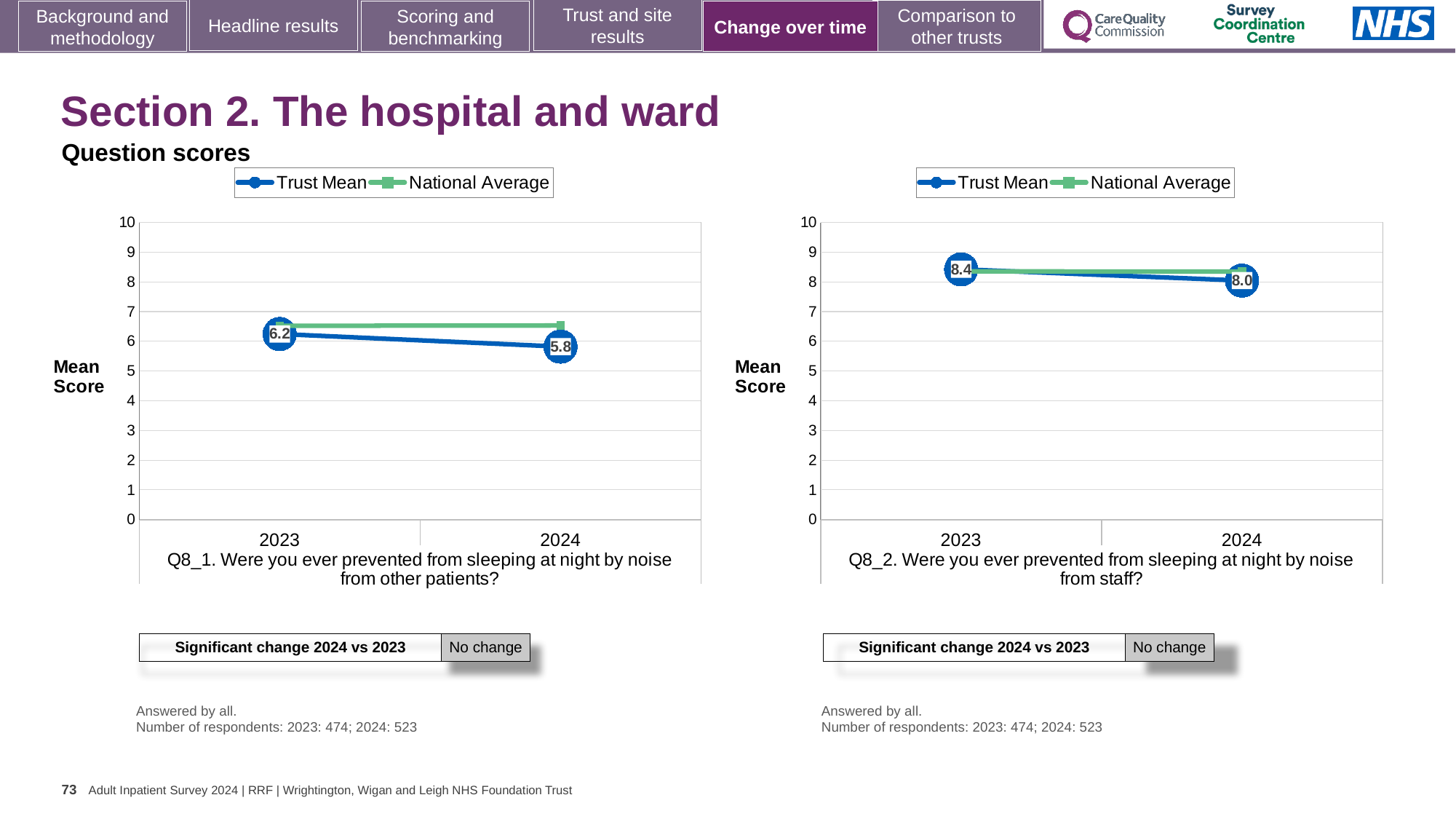
In the right chart (Q8_2), what is the Trust Mean score for 2023? 8.4 In the right chart (Q8_2), what is the Trust Mean score for 2024? 8.0 How many series does the legend of the right chart (Q8_2) list? 2 How many years are plotted on the x axis of the left chart (Q8_1)? 2 In the right chart (Q8_2), does the Trust Mean rise or fall from 2023 to 2024? fall In the left chart (Q8_1), which is larger in 2024: the Trust Mean or the National Average? National Average In the left chart (Q8_1), by how much did the Trust Mean change from 2023 to 2024? 0.4 In the right chart (Q8_2), what is the difference between the Trust Mean in 2023 and 2024? 0.4 In the left chart (Q8_1), is the National Average for 2024 greater or less than 6? greater In the left chart (Q8_1), what is the Trust Mean score for 2023? 6.2 In the left chart (Q8_1), what is the Trust Mean score for 2024? 5.8 What type of chart is the left chart (Q8_1)? line chart